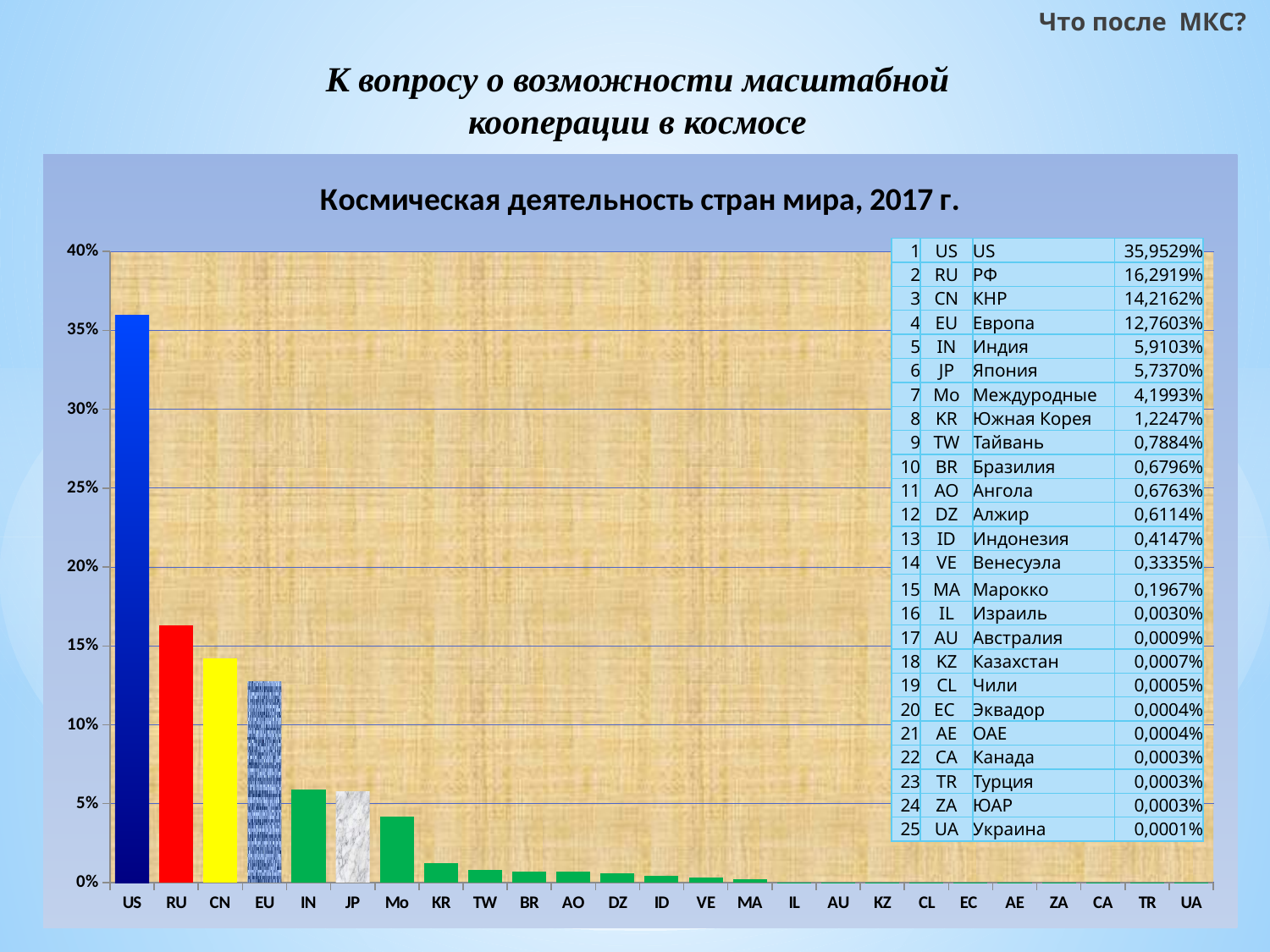
Which category has the lowest value in the chart? UA What is the value for US in the chart "Космическая деятельность стран мира, 2017 г."? 35,9529% What kind of chart is shown on the slide? bar chart Which is larger, the value for CN or the value for EU? CN What is the difference between the values for US and RU? 19,6610% What is the difference between the values for CN and EU? 1,4559% Which category has the highest value in the chart? US What is the value for RU (РФ) in the chart? 16,2919% How many categories are shown on the x axis of the chart? 25 What is the value for KR (Южная Корея) in the chart? 1,2247% Is the value for RU greater or less than 20%? less What is the value for EU (Европа) in the chart? 12,7603%